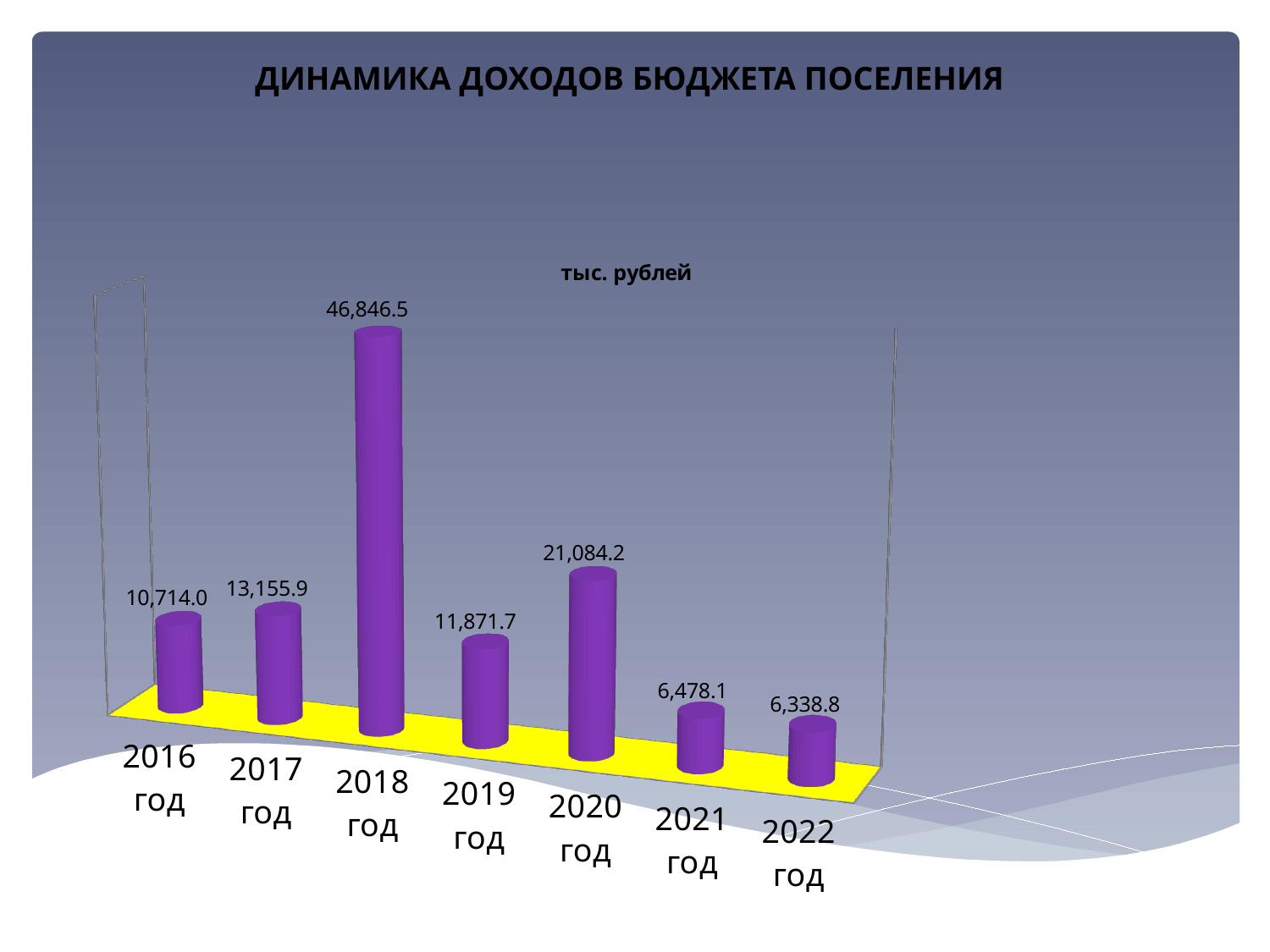
What is the title of the chart? ДИНАМИКА ДОХОДОВ БЮДЖЕТА ПОСЕЛЕНИЯ What is the value for 2018 год? 46,846.5 Which year has the lowest value? 2022 год What kind of chart is this? Bar chart What is the value for 2016 год? 10,714.0 What is the difference between the values for 2018 год and 2017 год? 33,690.6 What is the value for 2022 год? 6,338.8 What is the difference between the values for 2020 год and 2019 год? 9,212.5 How many years are shown on the chart? 7 Which year has the highest value? 2018 год What is the value for 2020 год? 21,084.2 Which is larger, the value for 2017 год or the value for 2019 год? 2017 год